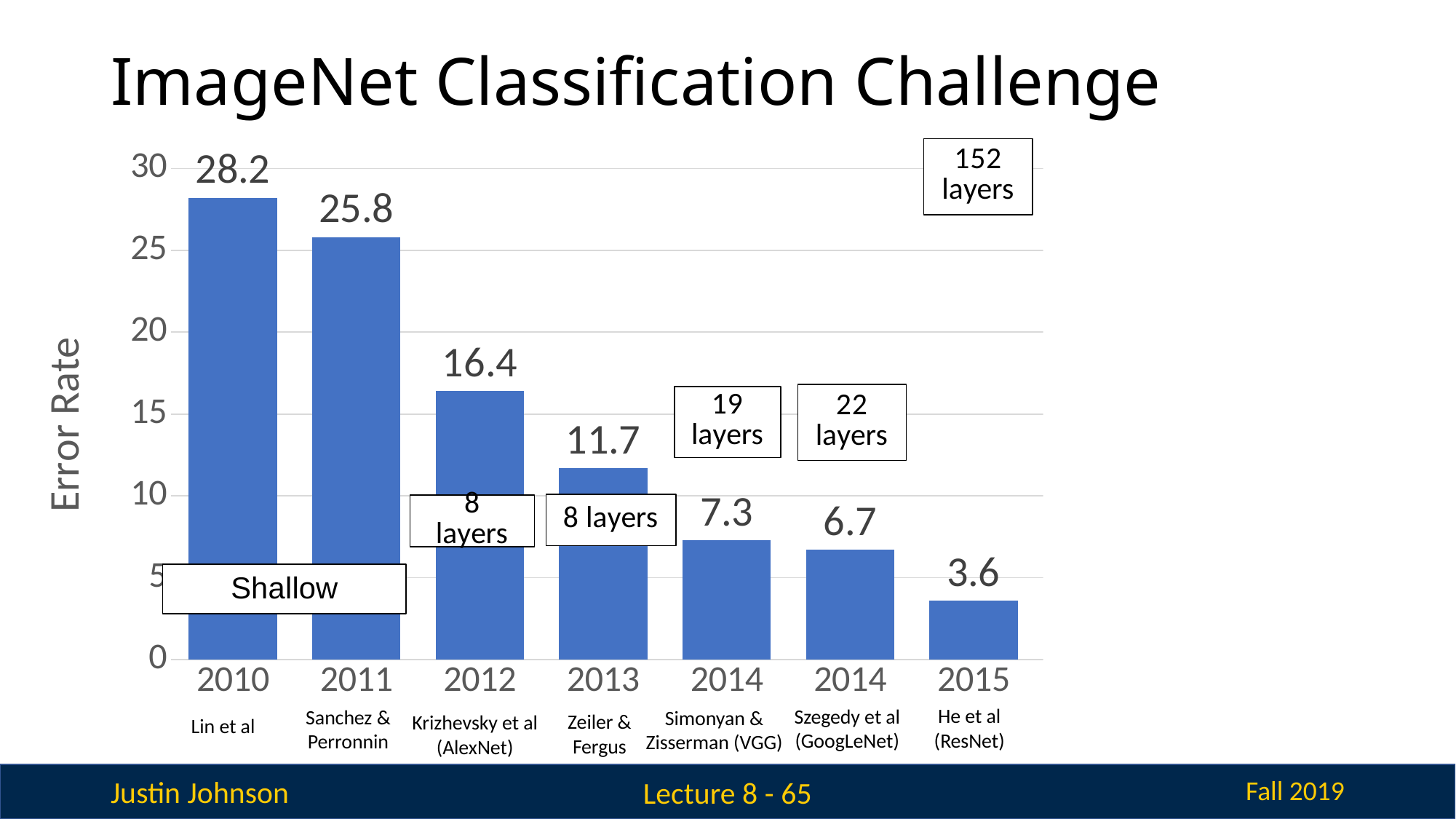
Which entry has the highest error rate? 2010 (Lin et al) What is the error rate for Simonyan & Zisserman (VGG) in 2014? 7.3 What is the label on the y axis of the chart? Error Rate What is the error rate for He et al (ResNet) in 2015? 3.6 Do the error rates rise or fall from 2010 to 2015 along the x axis? Fall What is the error rate for Krizhevsky et al (AlexNet) in 2012? 16.4 What is the difference in error rate between Sanchez & Perronnin (2011) and Krizhevsky et al (2012)? 9.4 How many bars are shown in the chart? 7 What is the difference in error rate between Zeiler & Fergus (2013) and Szegedy et al (GoogLeNet, 2014)? 5.0 What type of chart is shown on the slide? Bar chart Which entry has the lowest error rate? 2015 (He et al, ResNet) Which has a higher error rate, Simonyan & Zisserman (VGG) or Szegedy et al (GoogLeNet)? Simonyan & Zisserman (VGG)